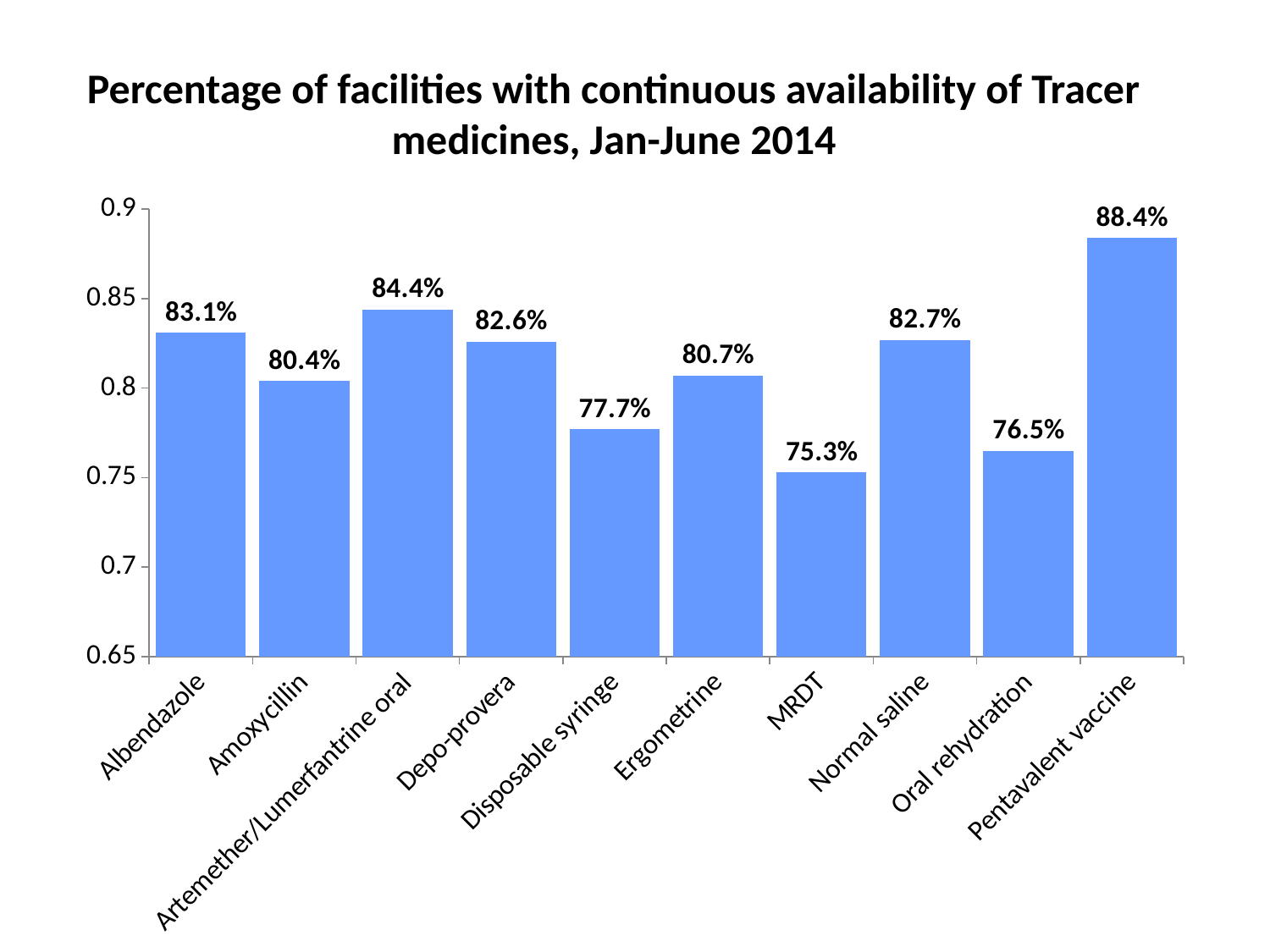
Which is larger, the value for Disposable syringe or the value for Oral rehydration? Disposable syringe What is the value for Albendazole? 83.1% What is the value for Normal saline? 82.7% Is the value for Ergometrine greater or less than 0.8? greater Which category has the lowest value? MRDT What is the value for MRDT? 75.3% Which category has the highest value? Pentavalent vaccine What is the difference between the values for Artemether/Lumerfantrine oral and Amoxycillin? 4.0% What kind of chart is shown on the slide? Bar chart How many categories are shown on the x axis? 10 What is the title of the chart? Percentage of facilities with continuous availability of Tracer medicines, Jan-June 2014 What is the difference between the values for Pentavalent vaccine and MRDT? 13.1%